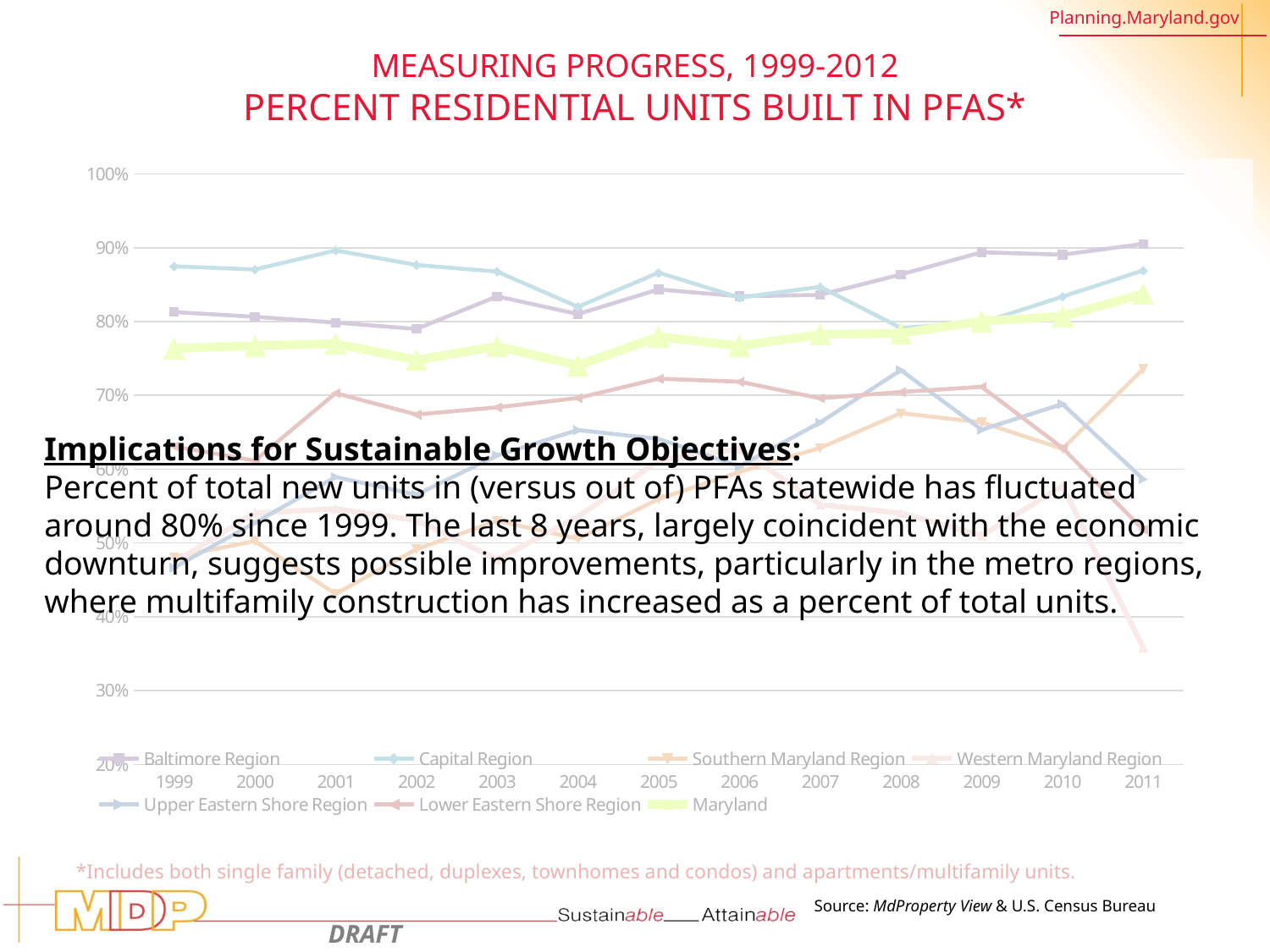
In 1999, which is higher: Capital Region or Baltimore Region? Capital Region Does the Maryland line rise or fall from 2004 to 2011? rise Which series has the lowest value in 2011? Western Maryland Region How many series does the chart legend list? 7 Which series has the highest value in 2011? Baltimore Region Is the value for Maryland in 1999 greater or less than 80%? less Is the value for Lower Eastern Shore Region in 2011 greater or less than 40%? greater What kind of chart is shown on the slide? line chart Which series has the highest value in 1999? Capital Region How many years are shown along the x axis of the chart? 13 Is the value for Maryland in 2011 greater or less than 80%? greater What is the title of the chart on the slide? MEASURING PROGRESS, 1999-2012 PERCENT RESIDENTIAL UNITS BUILT IN PFAS*